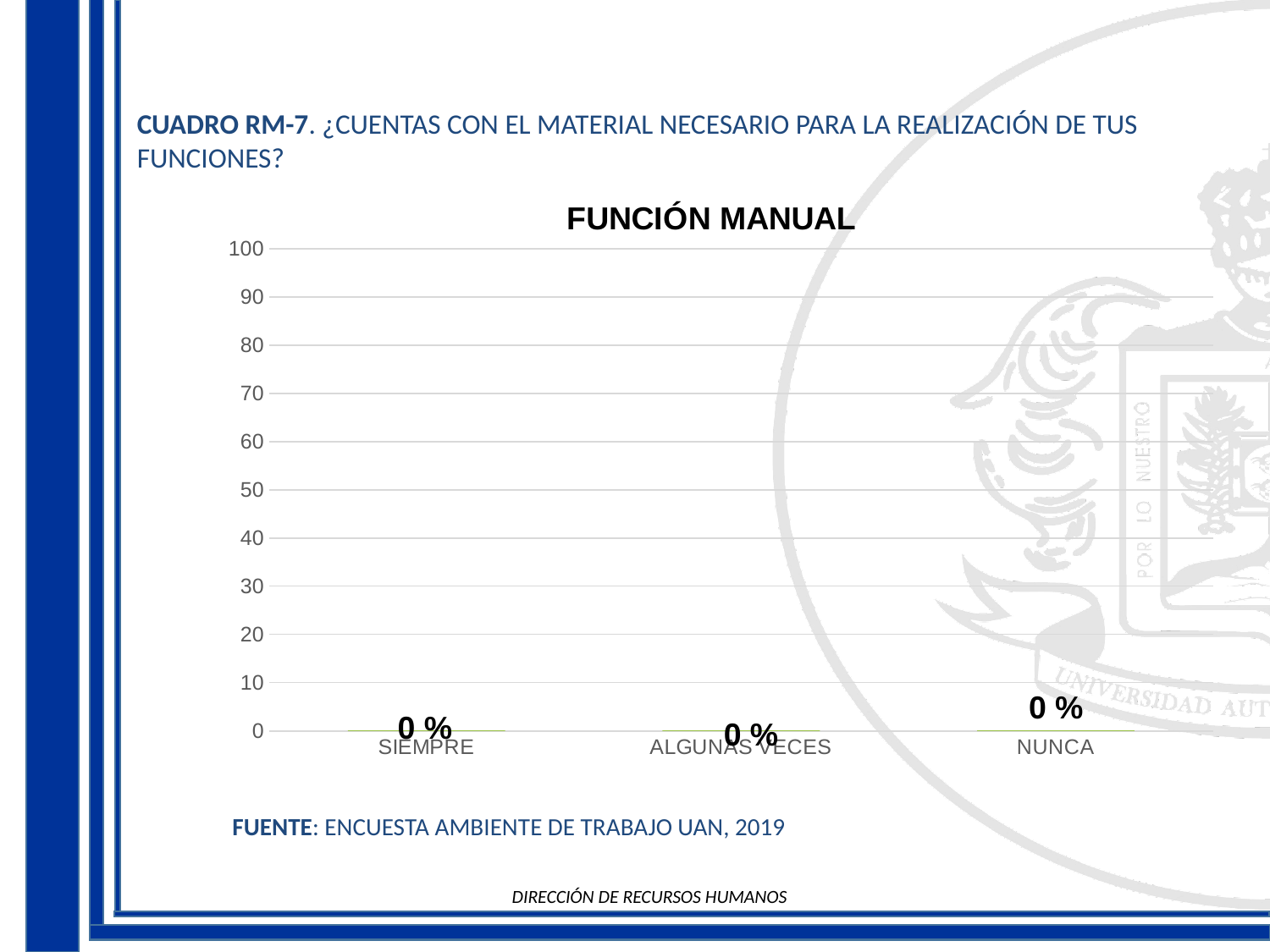
What is the value shown for NUNCA? 0 % How many categories are shown on the x axis of the chart? 3 What is the difference between the values for SIEMPRE and NUNCA? 0 % What is the value shown for ALGUNAS VECES? 0 % Is the value for SIEMPRE greater or less than 10? less What is the highest value shown on the vertical axis of the chart? 100 Is the value for NUNCA greater or less than 50? less What is the value shown for SIEMPRE? 0 % What is the title of the chart? FUNCIÓN MANUAL Do the values rise, fall, or stay flat from SIEMPRE to NUNCA? stay flat